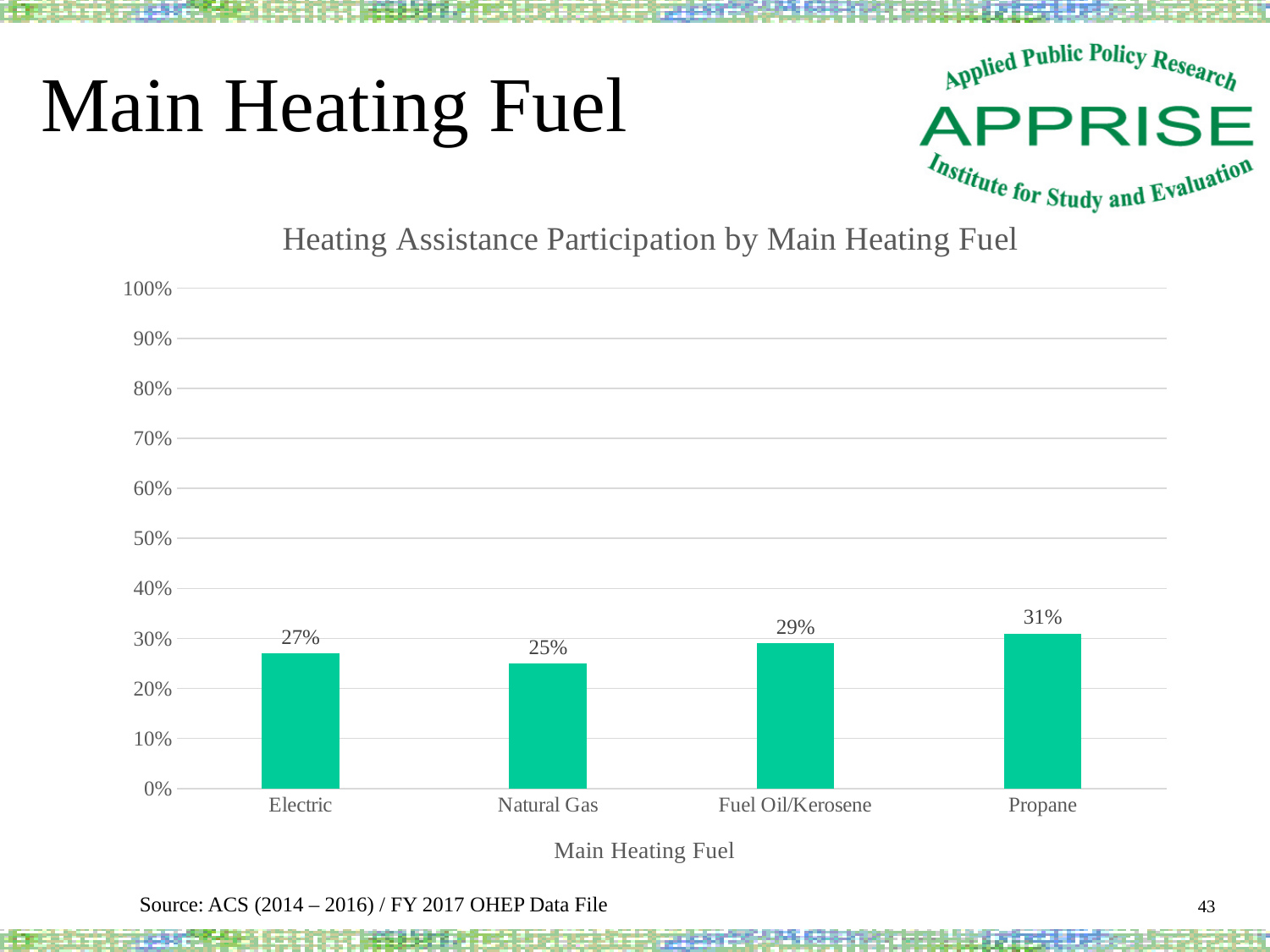
What is the heating assistance participation rate for Electric? 27% Which has a higher participation rate, Electric or Fuel Oil/Kerosene? Fuel Oil/Kerosene Which main heating fuel has the lowest heating assistance participation rate? Natural Gas Is the participation rate for Propane greater or less than 40%? less What is the heating assistance participation rate for Fuel Oil/Kerosene? 29% Which main heating fuel has the highest heating assistance participation rate? Propane What is the heating assistance participation rate for Propane? 31% What is the difference in participation rate between Propane and Natural Gas? 6% What is the heating assistance participation rate for Natural Gas? 25% What type of chart is shown on the slide? bar chart What is the title of the chart? Heating Assistance Participation by Main Heating Fuel How many main heating fuel categories are shown in the chart? 4